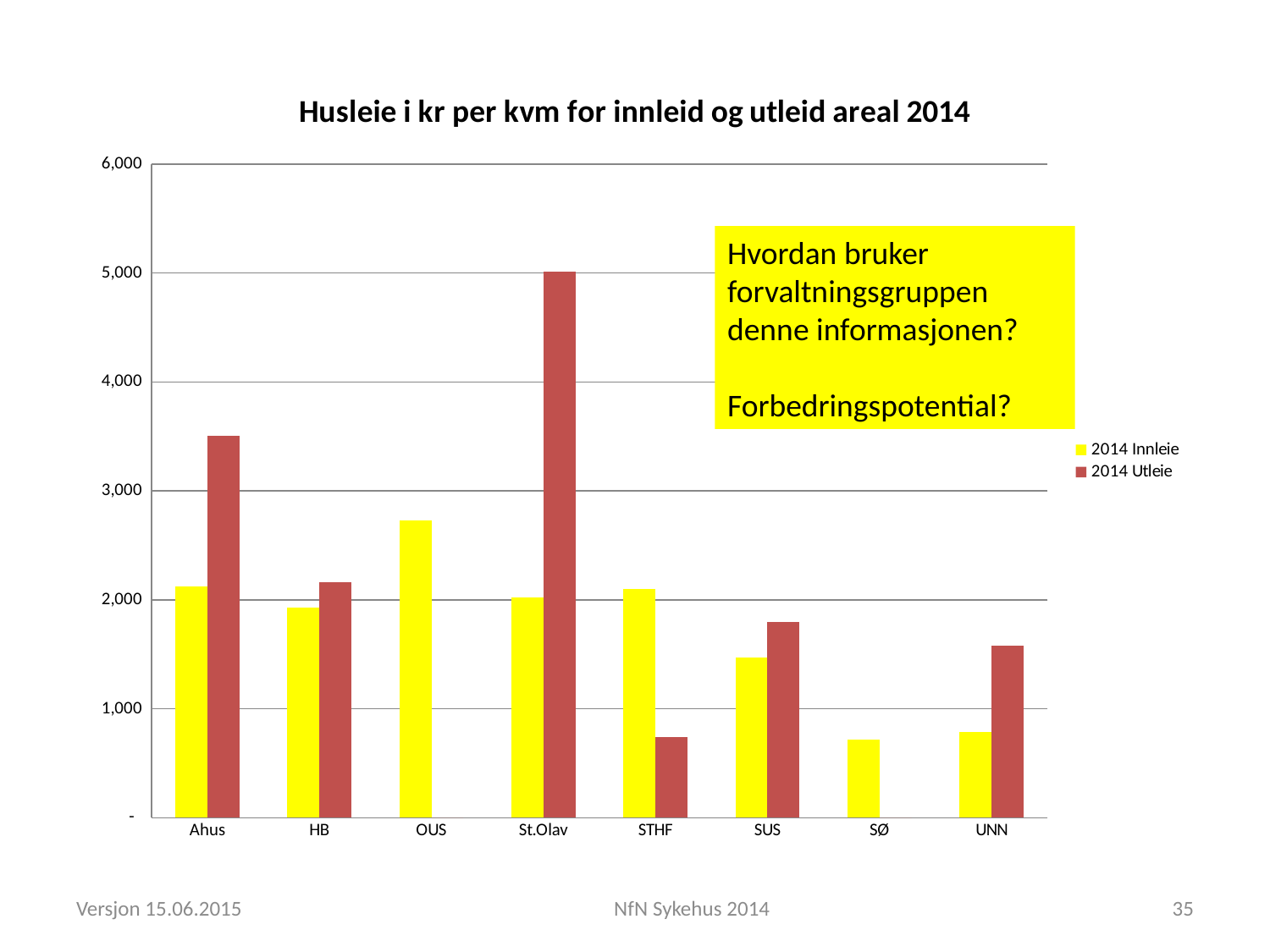
For UNN, which is larger: 2014 Innleie or 2014 Utleie? 2014 Utleie Which category has the highest value for 2014 Utleie? St.Olav Is the 2014 Utleie value for St.Olav greater or less than 4,000? greater What is the title of the chart? Husleie i kr per kvm for innleid og utleid areal 2014 Is the 2014 Innleie value for SØ greater or less than 1,000? less For STHF, which is larger: 2014 Innleie or 2014 Utleie? 2014 Innleie Is the 2014 Utleie value for Ahus greater or less than 3,000? greater How many categories are shown on the x axis? 8 How many series does the legend list? 2 Which category has the highest value for 2014 Innleie? OUS Among the categories with a 2014 Utleie bar, which has the lowest value? STHF What kind of chart is shown on the slide? bar chart